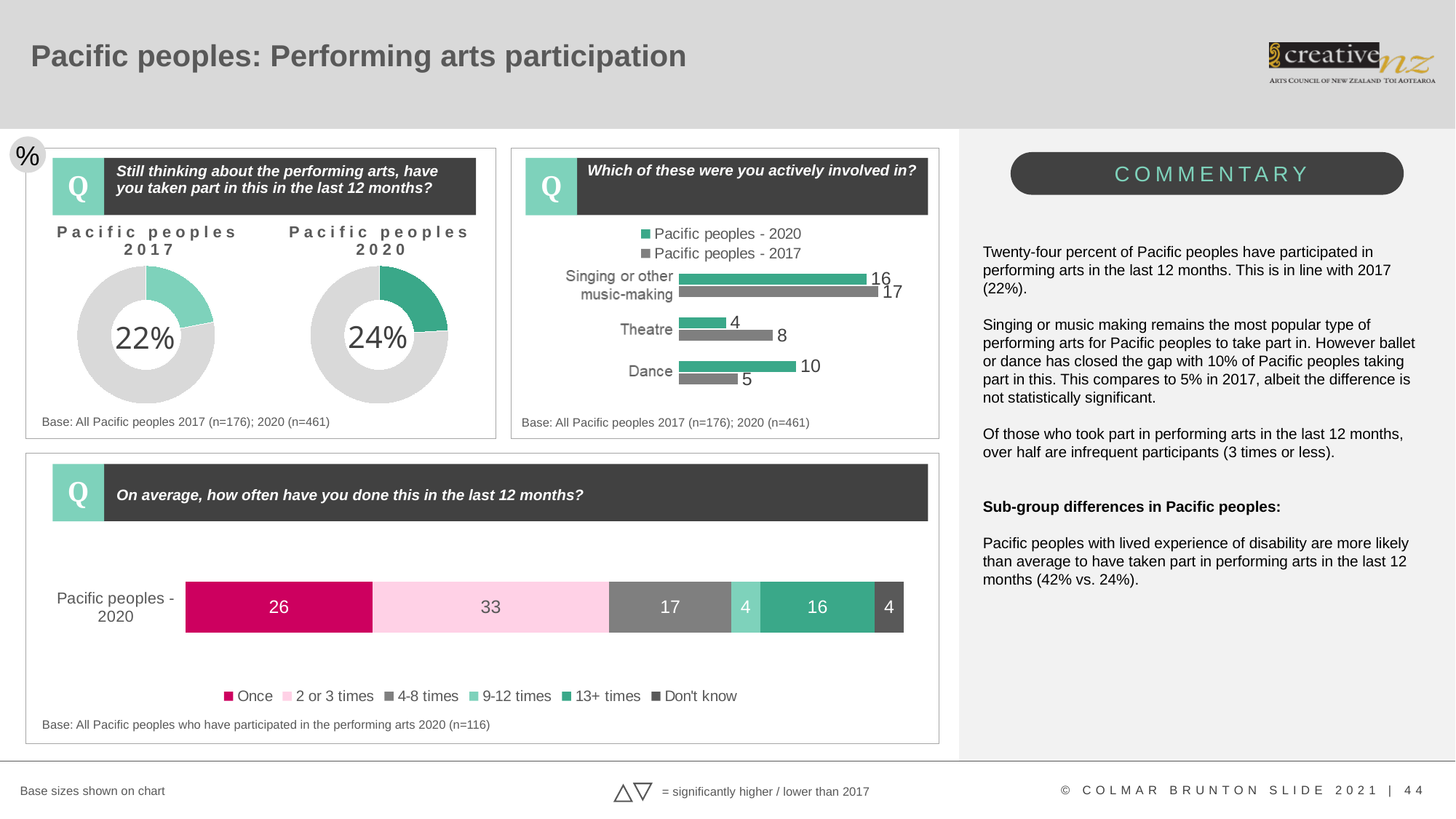
In the 'On average, how often have you done this in the last 12 months?' chart, what is the value for '2 or 3 times'? 33 In the donut charts at the top left, what percentage of Pacific peoples took part in performing arts in 2017? 22% In the 'Which of these were you actively involved in?' chart, which category has the lowest value for Pacific peoples - 2020? Theatre In the 'Which of these were you actively involved in?' chart, is the Dance value larger for Pacific peoples - 2020 or Pacific peoples - 2017? Pacific peoples - 2020 What kind of chart is the 'On average, how often have you done this in the last 12 months?' chart? Stacked bar chart In the 'Which of these were you actively involved in?' chart, which category has the highest value for Pacific peoples - 2020? Singing or other music-making In the 'Which of these were you actively involved in?' chart, what is the value for Dance for Pacific peoples - 2020? 10 In the donut charts at the top left, what percentage of Pacific peoples took part in performing arts in 2020? 24% How many series does the legend of the 'Which of these were you actively involved in?' chart list? 2 In the 'On average, how often have you done this in the last 12 months?' chart, what is the total of the stacked bar for Pacific peoples - 2020? 100 In the 'Which of these were you actively involved in?' chart, what is the value for Theatre for Pacific peoples - 2017? 8 In the 'Which of these were you actively involved in?' chart, what is the difference between the 2017 and 2020 values for Theatre? 4